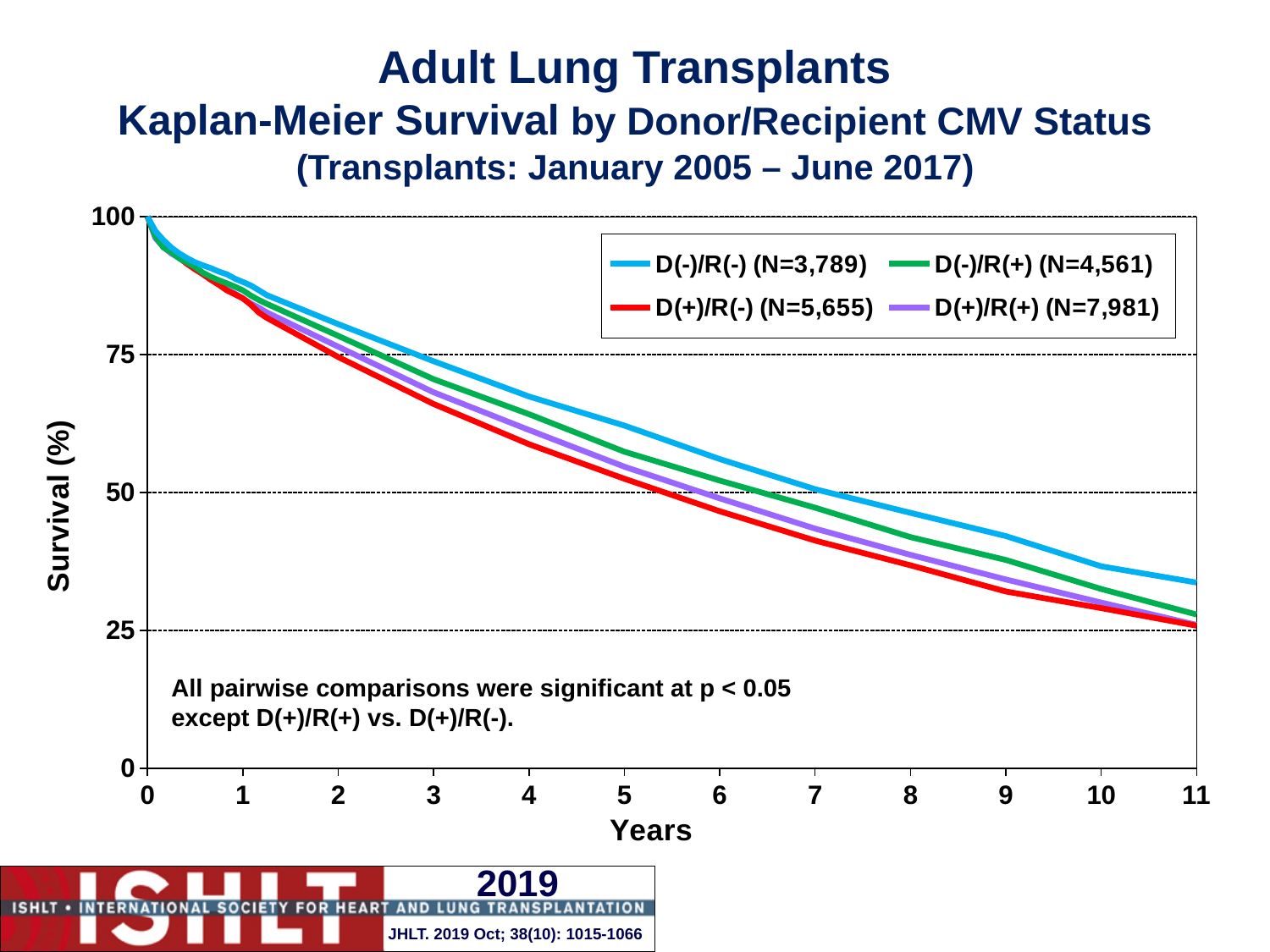
Which CMV status group has the lowest survival across the follow-up period? D(+)/R(-) What is the label of the y axis? Survival (%) Do the survival curves rise or fall as years increase? Fall Is the survival for D(-)/R(-) at 5 years greater or less than 50? greater Is the survival for D(+)/R(+) at 3 years greater or less than 75? less At 5 years, is survival higher for D(-)/R(-) or for D(+)/R(-)? D(-)/R(-) Which CMV status group has the highest survival across the follow-up period? D(-)/R(-) Is the survival for D(+)/R(-) at 7 years greater or less than 50? less What kind of chart is shown on the slide? Line chart How many series does the legend list? 4 According to the legend, what is the N for the D(+)/R(+) group? N=7,981